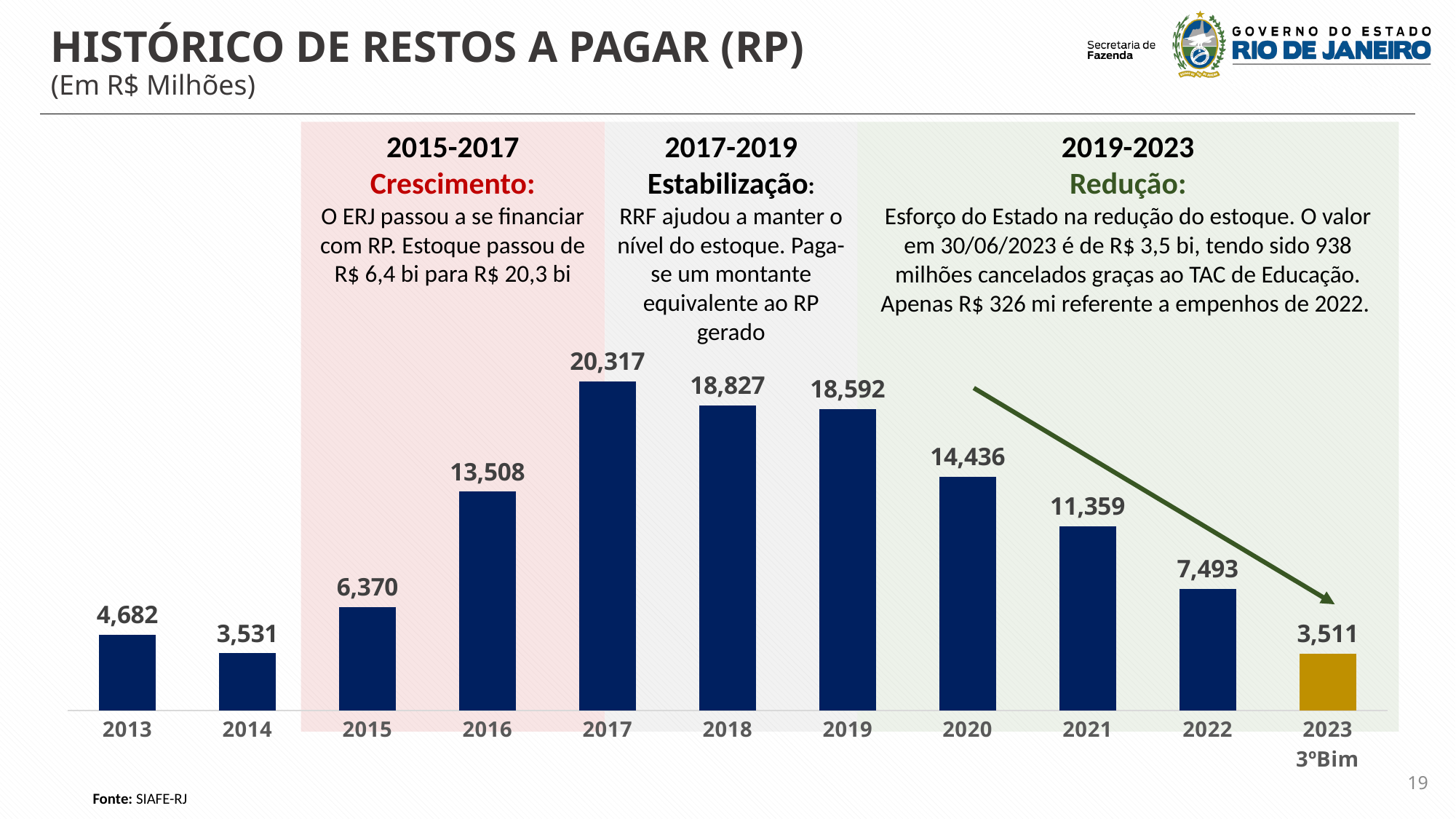
How many bars are shown in the chart? 11 What is the difference between the values for 2022 and 2023 3ºBim? 3,982 What is the value for 2020? 14,436 What is the value for 2023 3ºBim? 3,511 Which year has the highest value? 2017 Which category has the lowest value? 2023 3ºBim What is the value for 2017? 20,317 What is the difference between the values for 2017 and 2016? 6,809 What is the title of the chart on the slide? HISTÓRICO DE RESTOS A PAGAR (RP) Do the values rise or fall from 2017 to 2023 3ºBim? Fall What kind of chart is shown on the slide? Bar chart Which is larger, the value for 2018 or the value for 2019? 2018